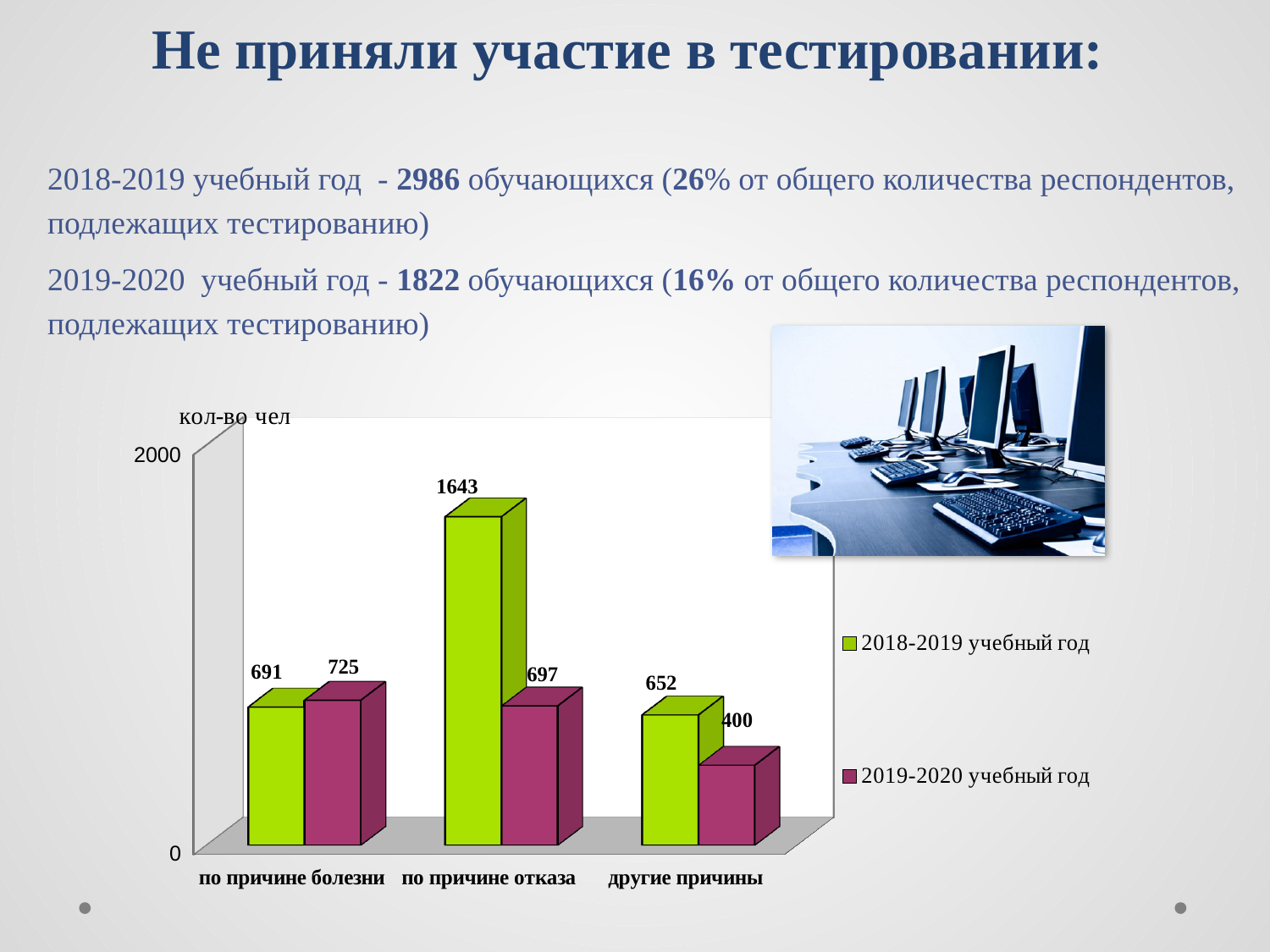
Is the value for 'по причине отказа' in the 2018-2019 учебный год series greater or less than 2000? less What is the value for 'по причине отказа' in the 2018-2019 учебный год series? 1643 Which category has the lowest value in the 2019-2020 учебный год series? другие причины What is the difference between the 2018-2019 and 2019-2020 values for 'по причине отказа'? 946 What is the value for 'по причине болезни' in the 2019-2020 учебный год series? 725 How many categories are shown on the x axis of the chart? 3 What is the value for 'другие причины' in the 2019-2020 учебный год series? 400 What label is shown on the vertical axis of the chart? кол-во чел How many series does the chart legend list? 2 For 'по причине болезни', which series has the larger value: 2018-2019 учебный год or 2019-2020 учебный год? 2019-2020 учебный год Which category has the highest value in the 2018-2019 учебный год series? по причине отказа What kind of chart is shown on the slide? bar chart